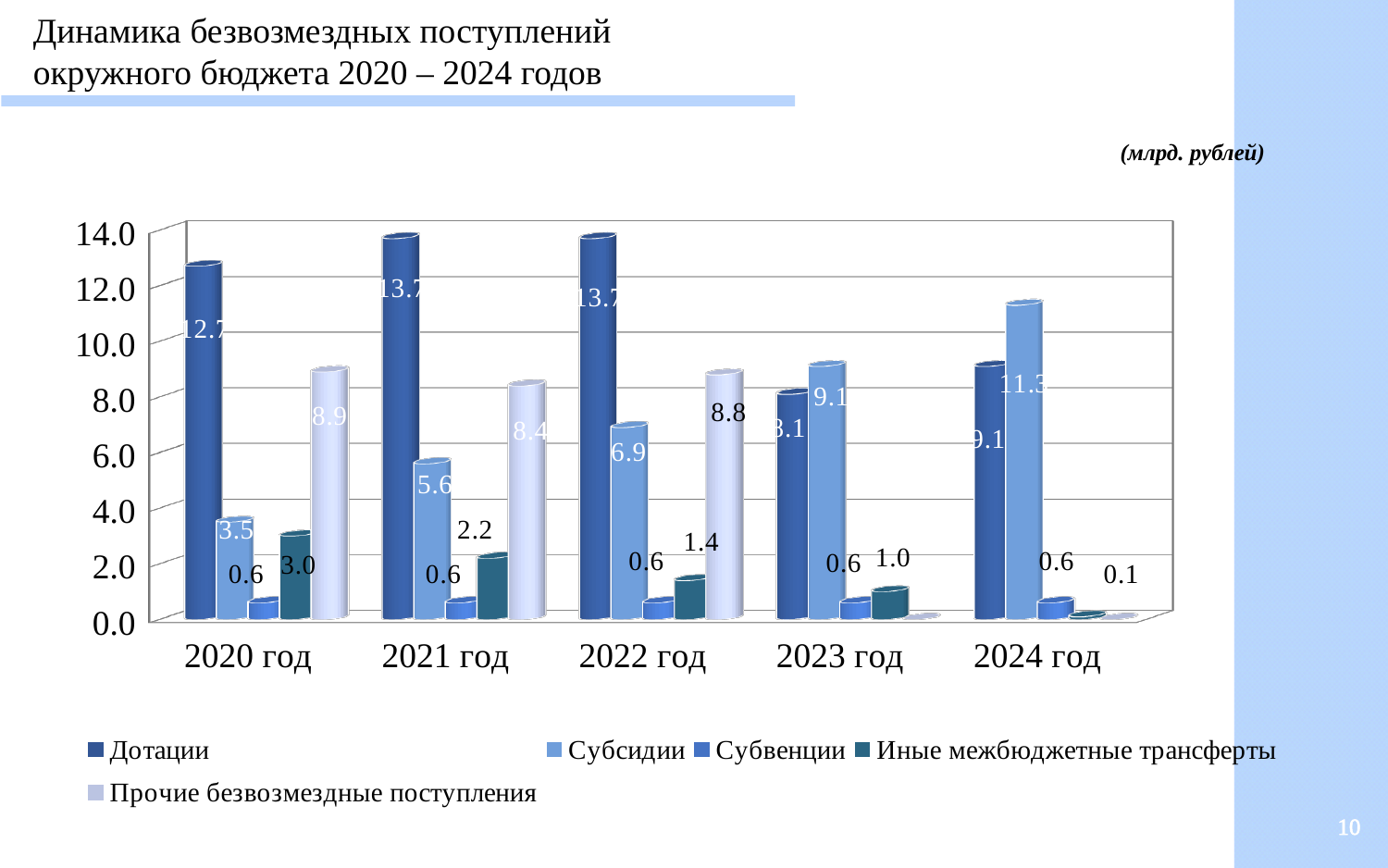
Is the value for Дотации in 2022 год greater or less than 12.0? greater What kind of chart is shown on the slide? bar chart How many series does the legend list? 5 Do the values for Субсидии rise or fall from 2020 год to 2024 год? rise In which year is the value for Субсидии the highest? 2024 год How many years are shown on the x axis? 5 What is the value for Прочие безвозмездные поступления in 2020 год? 8.9 What is the value for Дотации in 2020 год? 12.7 In which year is the value for Иные межбюджетные трансферты the lowest? 2024 год In 2023 год, which is larger: Дотации or Субсидии? Субсидии By how much does the value for Дотации in 2021 год exceed the value in 2020 год? 1.0 What is the value for Субсидии in 2024 год? 11.3